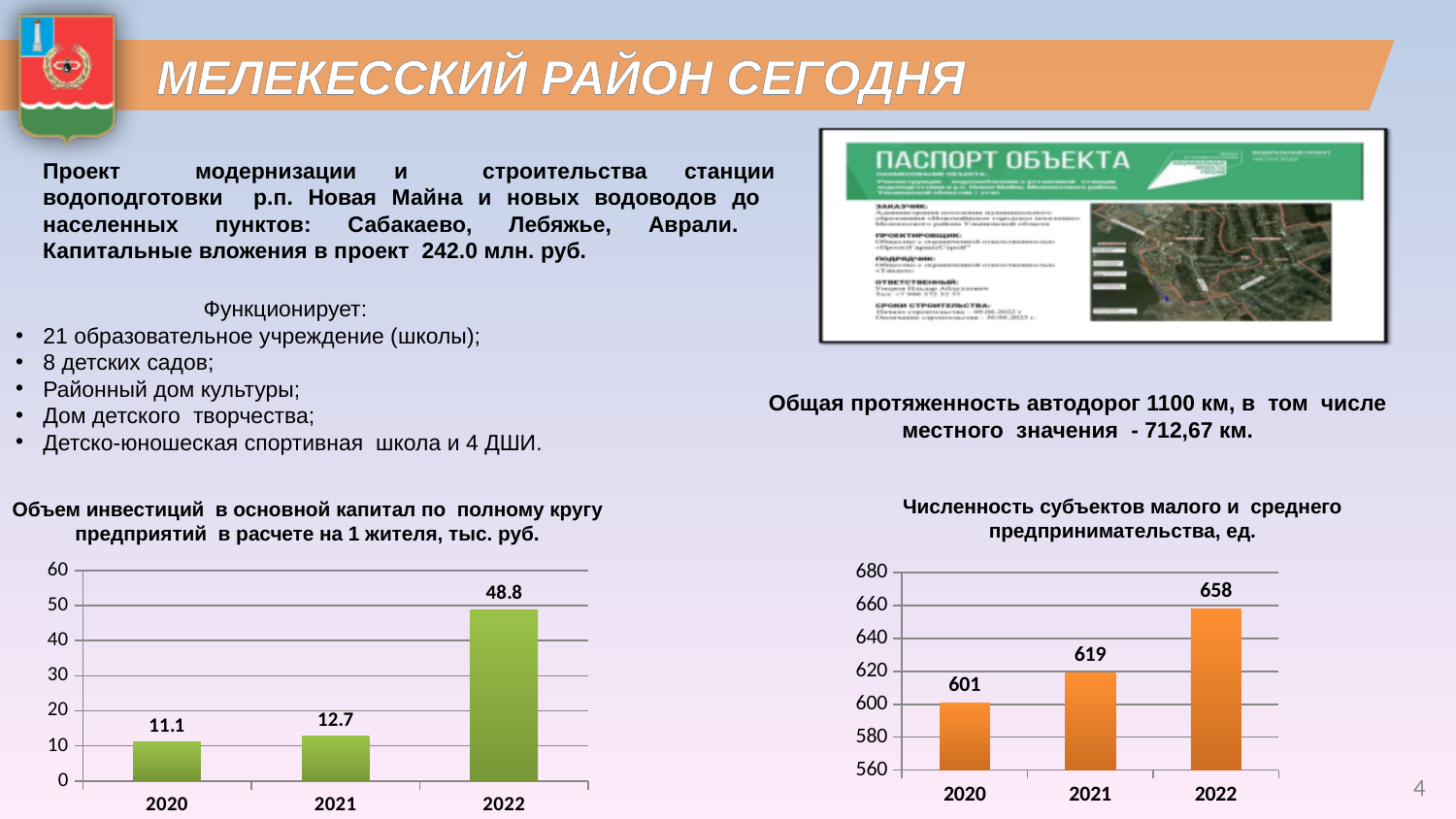
In the left chart (investment per resident, тыс. руб.), do the values rise or fall from 2020 to 2022? rise In the left chart (investment per resident, тыс. руб.), what is the difference between the 2022 and 2021 values? 36.1 In the right chart (number of small and medium business entities, ед.), which is larger, the value for 2020 or 2021? 2021 In the left chart (investment per resident, тыс. руб.), what is the value for 2022? 48.8 What type of chart is the right chart (number of small and medium business entities, ед.)? bar chart In the right chart (number of small and medium business entities, ед.), what is the value for 2022? 658 In the right chart (number of small and medium business entities, ед.), how many years are shown on the x axis? 3 In the left chart (investment per resident, тыс. руб.), which year has the highest value? 2022 In the left chart (investment per resident, тыс. руб.), which year has the lowest value? 2020 In the right chart (number of small and medium business entities, ед.), what is the difference between the 2022 and 2020 values? 57 In the right chart (number of small and medium business entities, ед.), what is the value for 2021? 619 In the left chart (investment per resident, тыс. руб.), what is the value for 2020? 11.1